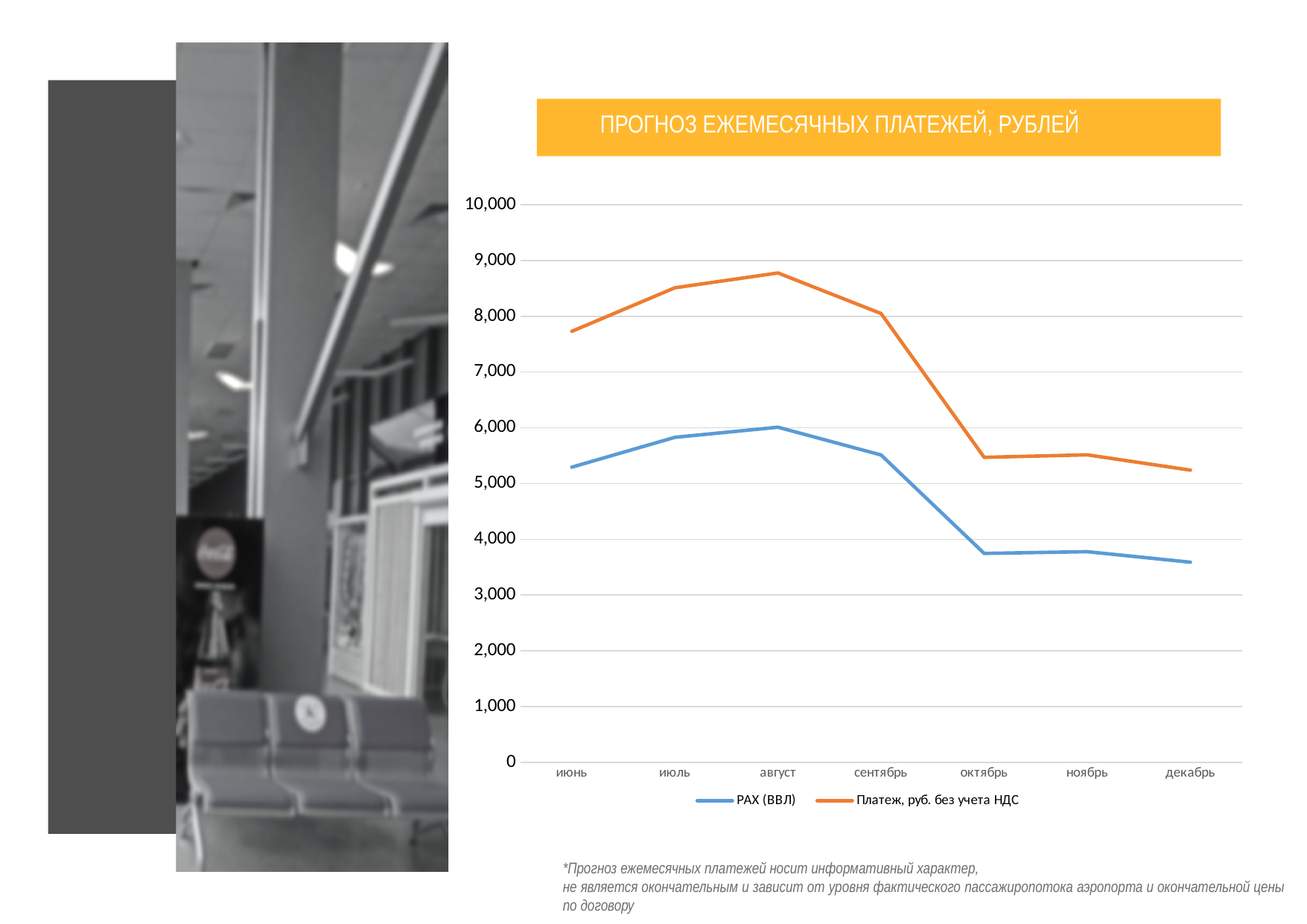
Is the value of Платеж, руб. без учета НДС for август greater or less than 9,000? less Is the value of PAX (ВВЛ) for декабрь greater or less than 4,000? less In сентябрь, which series has the larger value, PAX (ВВЛ) or Платеж, руб. без учета НДС? Платеж, руб. без учета НДС What kind of chart is shown on the slide? line chart In which month does the series PAX (ВВЛ) reach its highest value? август How many months are shown on the x axis? 7 In which month does the series Платеж, руб. без учета НДС reach its highest value? август What is the title of the chart? ПРОГНОЗ ЕЖЕМЕСЯЧНЫХ ПЛАТЕЖЕЙ, РУБЛЕЙ Is the value of Платеж, руб. без учета НДС for июнь greater or less than 7,000? greater How many series does the legend list? 2 Which series is drawn in orange? Платеж, руб. без учета НДС Do the values of PAX (ВВЛ) rise or fall from август to октябрь? fall